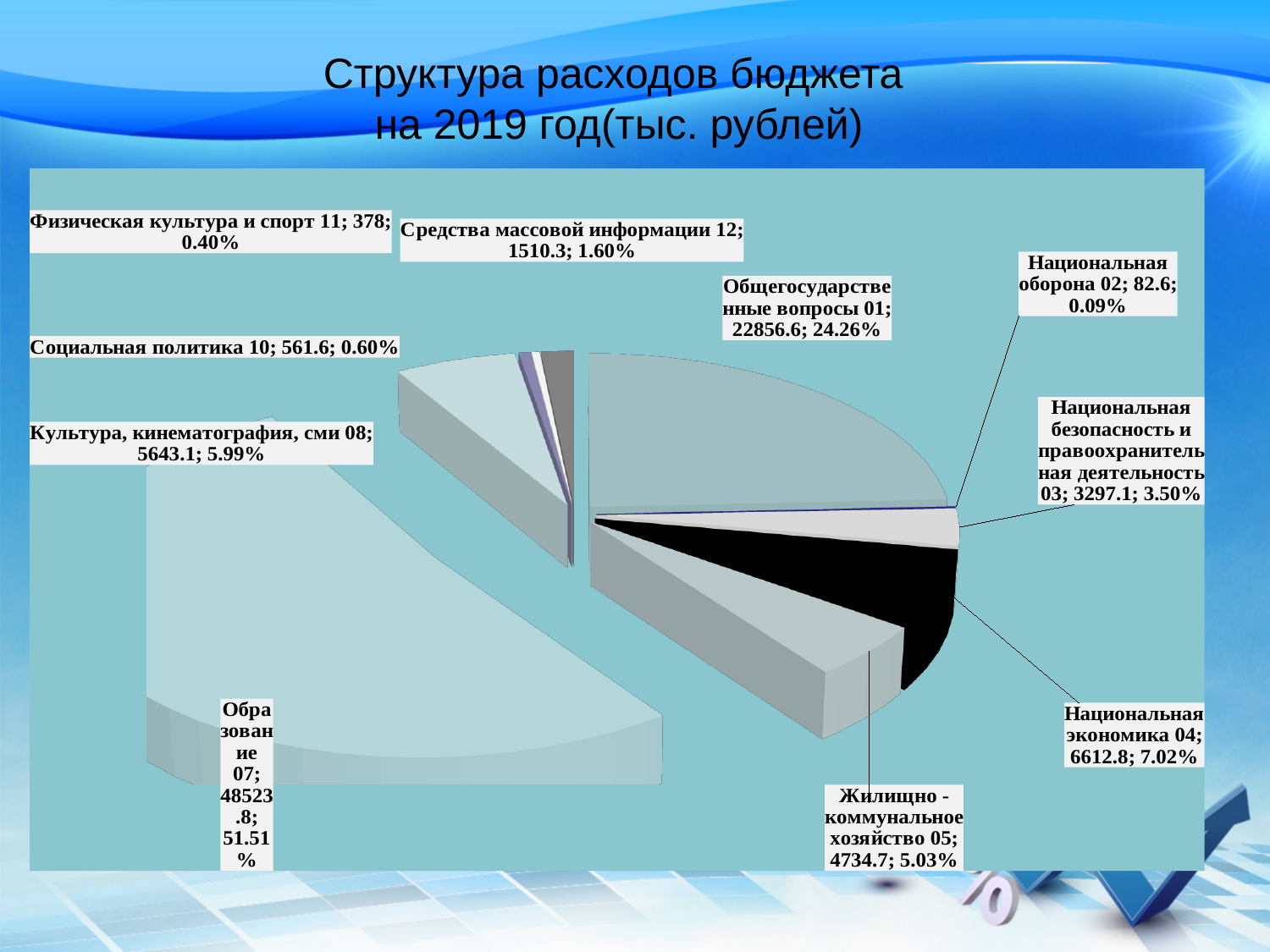
What is the value for Образование 07? 48523.8 Which is larger: the value for Культура, кинематография, сми 08 or the value for Жилищно-коммунальное хозяйство 05? Культура, кинематография, сми 08 What is the value for Национальная безопасность и правоохранительная деятельность 03? 3297.1 What share of the pie does Национальная экономика 04 represent? 7.02% What kind of chart is shown on the slide? Pie chart What is the title of the chart on the slide? Структура расходов бюджета на 2019 год(тыс. рублей) Which category has the largest slice of the pie? Образование 07 What is the difference between the values for Национальная экономика 04 and Жилищно-коммунальное хозяйство 05? 1878.1 Which category has the smallest slice of the pie? Национальная оборона 02 What is the value for Общегосударственные вопросы 01? 22856.6 What share of the pie does Образование 07 represent? 51.51% How many categories (slices) does the pie chart have? 10